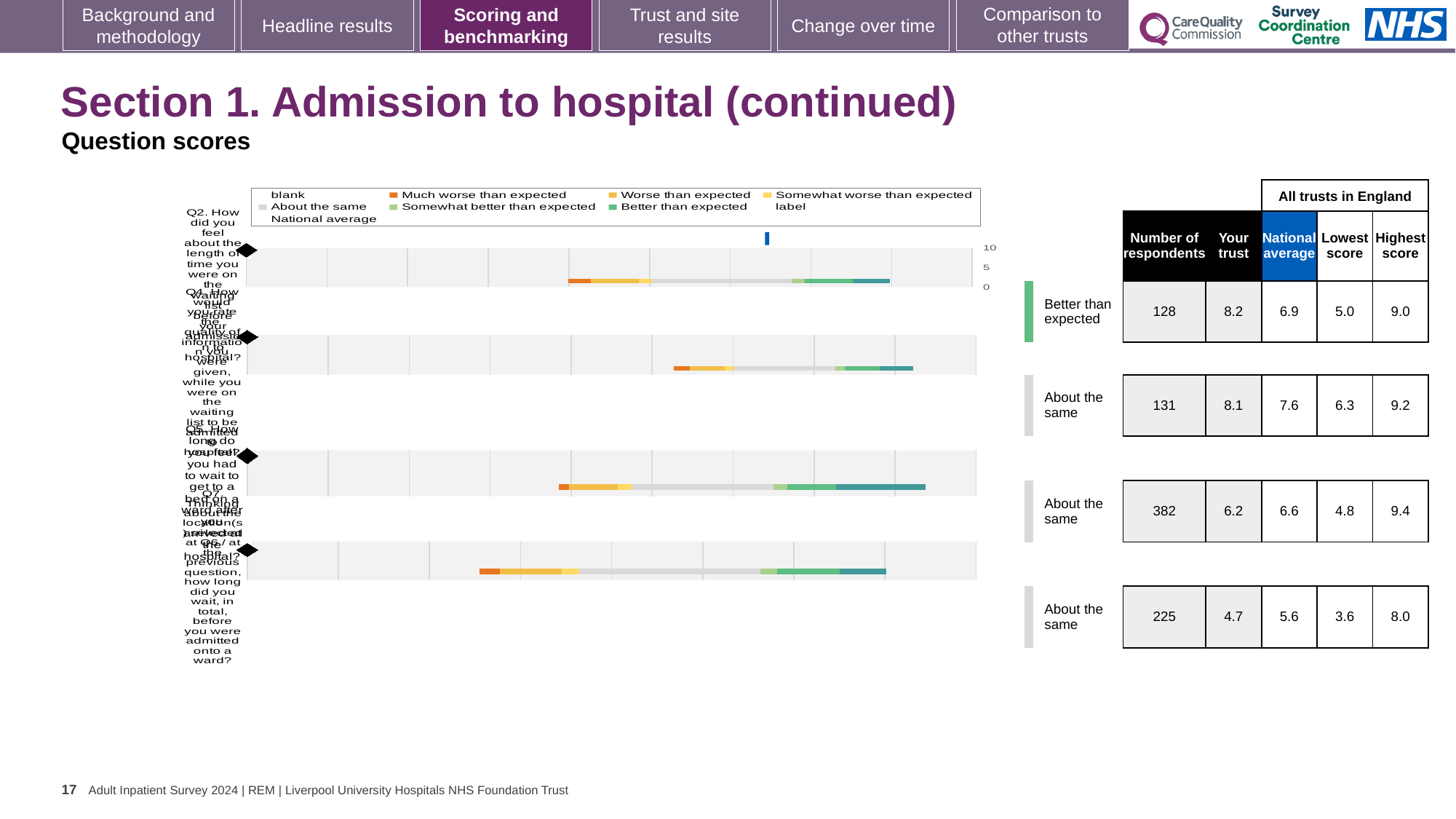
In the table beside the chart, is the 'Your trust' score for the third row larger or smaller than its national average? smaller Which legend entry is shown in dark teal in the chart? Better than expected How many question bars are plotted in the chart? 4 In the table beside the chart, which question row has the highest 'Your trust' score? the first row (8.2) In the table beside the chart, which question row has the lowest 'Your trust' score? the last row (4.7) How many entries does the chart's legend list? 9 In the table beside the chart, what is the 'Your trust' score for the first question row (Better than expected)? 8.2 What kind of chart is shown on the slide? bar chart In the table beside the chart, what is the national average for the last question row? 5.6 Which legend entry is shown in orange-red in the chart? Much worse than expected In the table beside the chart, what is the difference between the highest score and lowest score for the second question row? 2.9 In the table beside the chart, what is the number of respondents for the third question row? 382